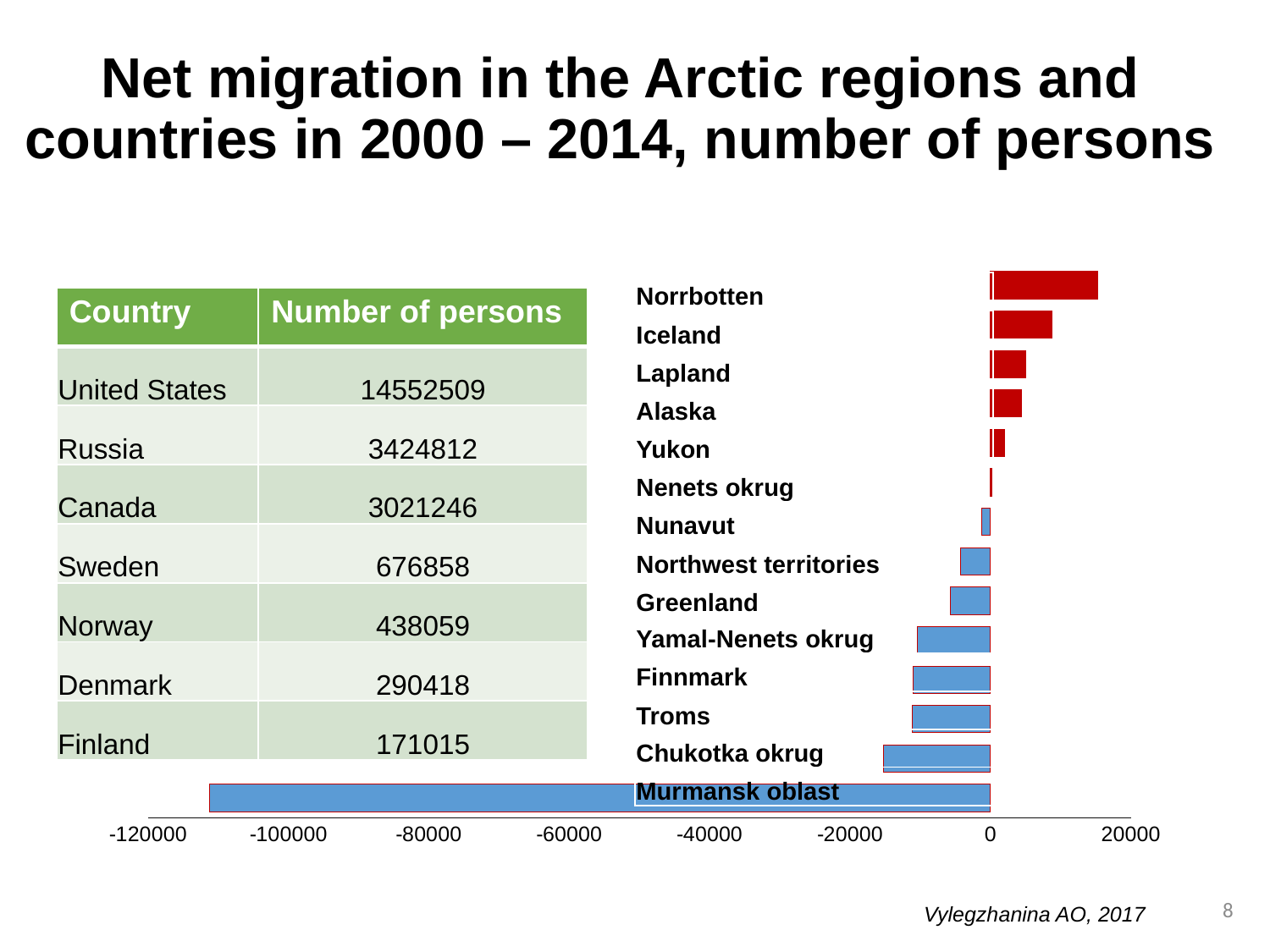
Which region has the lowest net migration in the bar chart? Murmansk oblast Which region is listed at the top of the bar chart? Norrbotten Which has the larger net migration, Norrbotten or Iceland? Norrbotten Is the value for Iceland greater or less than 0? greater What colour are the bars with negative net migration in the chart? blue Which has the larger net migration, Chukotka okrug or Murmansk oblast? Chukotka okrug Is the value for Chukotka okrug greater or less than -20000? greater Which region has the highest net migration in the bar chart? Norrbotten Is the value for Norrbotten greater or less than 20000? less What kind of chart is shown on the slide? bar chart How many regions are plotted in the bar chart? 14